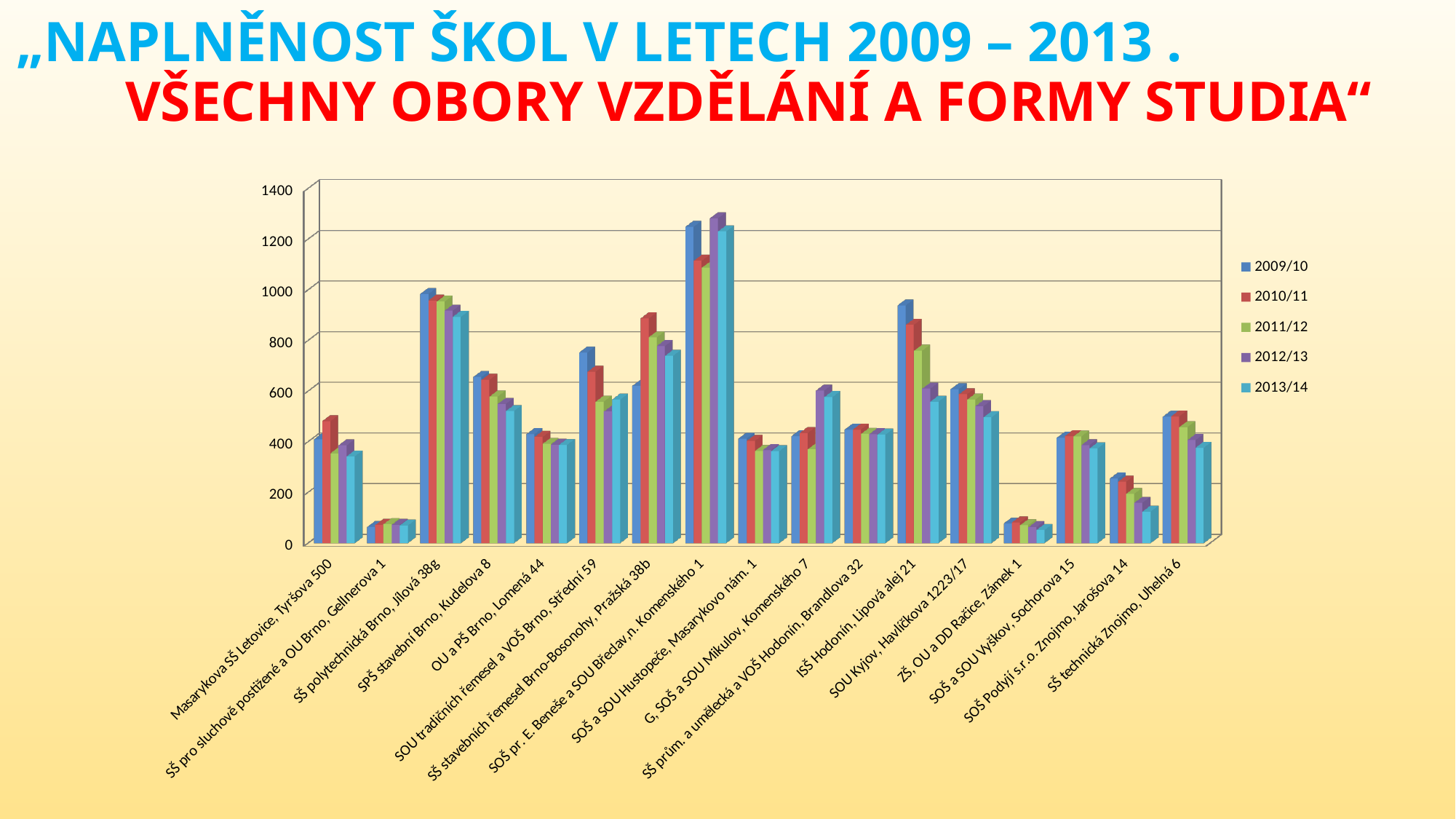
What kind of chart is shown on the slide? bar chart How many series does the legend list? 5 Which school has the highest value for the 2009/10 series? SOŠ pr. E. Beneše a SOU Břeclav, n. Komenského 1 Which school has the highest bars overall in the chart? SOŠ pr. E. Beneše a SOU Břeclav, n. Komenského 1 For the 2009/10 series, which is larger: SŠ polytechnická Brno, Jílová 38g or SPŠ stavební Brno, Kudelova 8? SŠ polytechnická Brno, Jílová 38g Do the values for ISŠ Hodonín, Lipová alej 21 rise or fall from 2009/10 to 2013/14? fall Is the 2009/10 value for ZŠ, OU a DD Račice, Zámek 1 greater or less than 200? less How many schools (categories) are shown on the x axis? 17 Is the 2009/10 value for SŠ polytechnická Brno, Jílová 38g greater or less than 800? greater Which school year is the first entry in the legend? 2009/10 Is the 2013/14 value for SOŠ Podyjí s.r.o. Znojmo, Jarošova 14 greater or less than 200? less